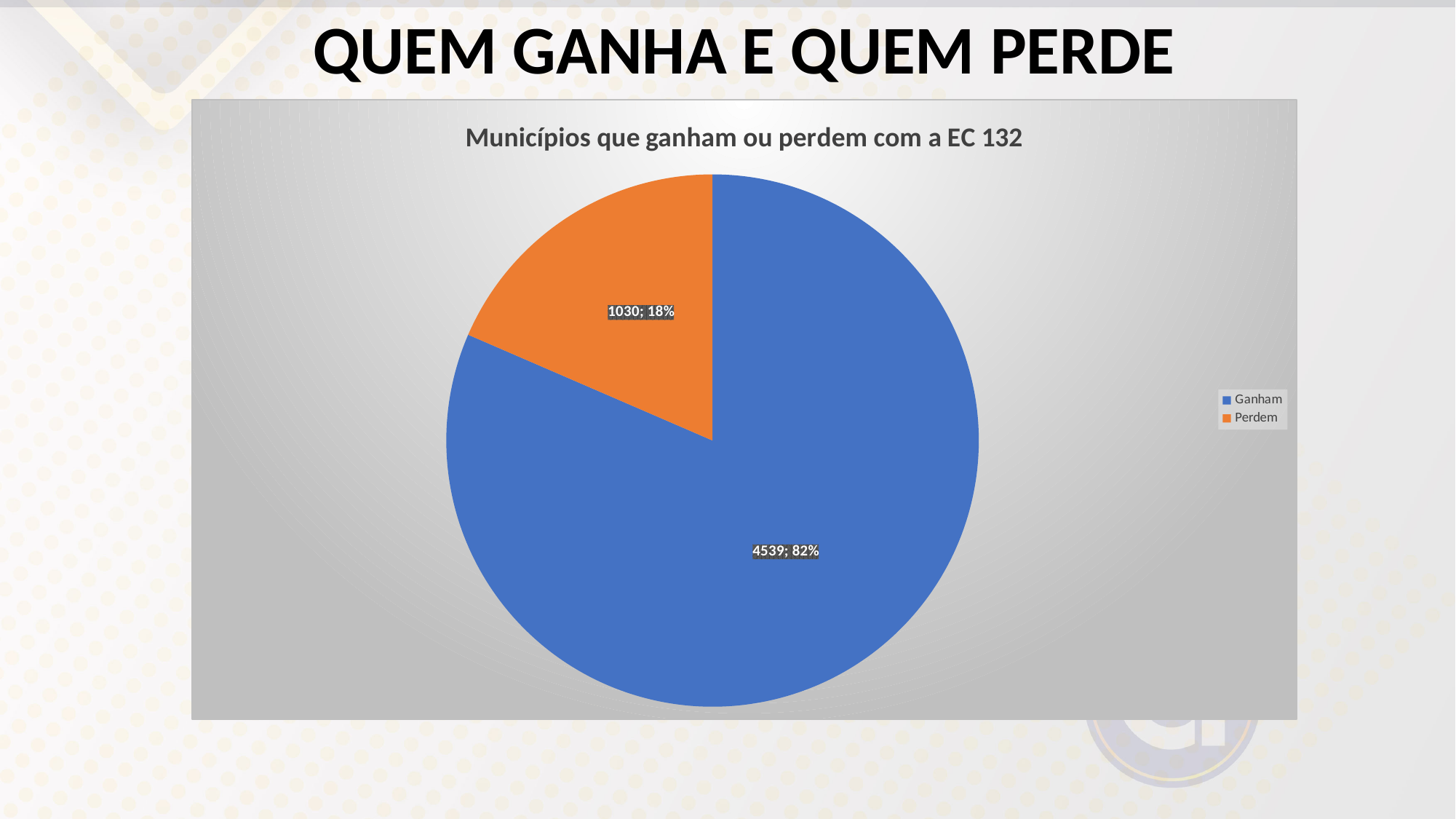
Which category has the smallest slice? Perdem Which category has the largest slice? Ganham What is the value for Perdem? 1030 What share of the pie does Perdem represent? 18% What is the difference between the values for Ganham and Perdem? 3509 What is the value for Ganham? 4539 What is the title of the chart? Municípios que ganham ou perdem com a EC 132 How many slices does the pie chart have? 2 What is the total of the two slices? 5569 What share of the pie does Ganham represent? 82% How many entries does the legend list? 2 What kind of chart is shown on the slide? Pie chart